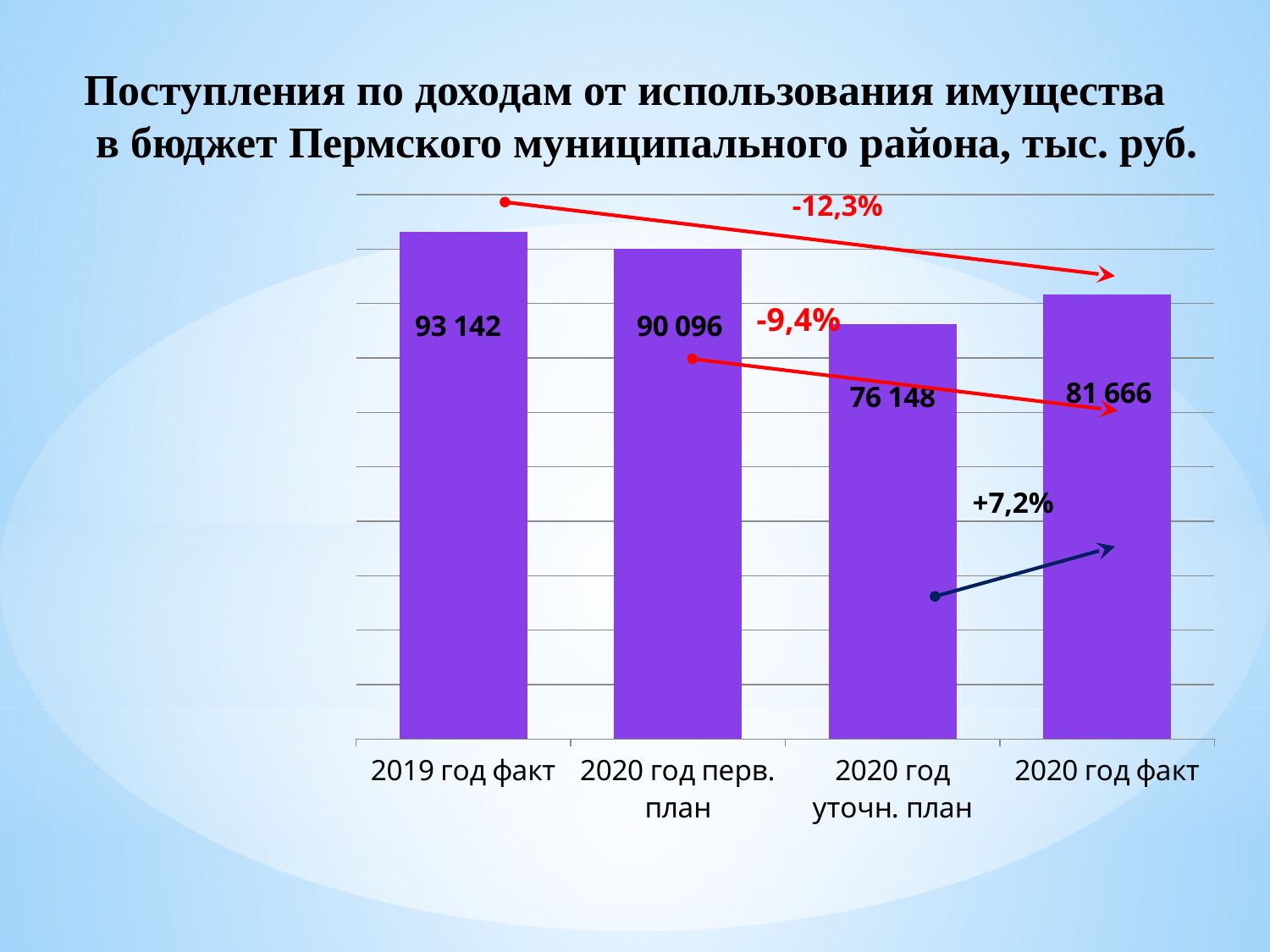
Which category has the lowest value? 2020 год уточн. план What is the value for 2020 год перв. план? 90 096 Which category has the highest value? 2019 год факт Which is larger, the value for 2020 год перв. план or the value for 2020 год факт? 2020 год перв. план What is the value for 2019 год факт? 93 142 What kind of chart is shown on the slide? bar chart What is the difference between the values for 2020 год факт and 2020 год уточн. план? 5 518 What percentage change is annotated between 2019 год факт and 2020 год факт? -12,3% What is the value for 2020 год факт? 81 666 What is the difference between the values for 2019 год факт and 2020 год факт? 11 476 What is the value for 2020 год уточн. план? 76 148 How many categories are shown on the chart? 4